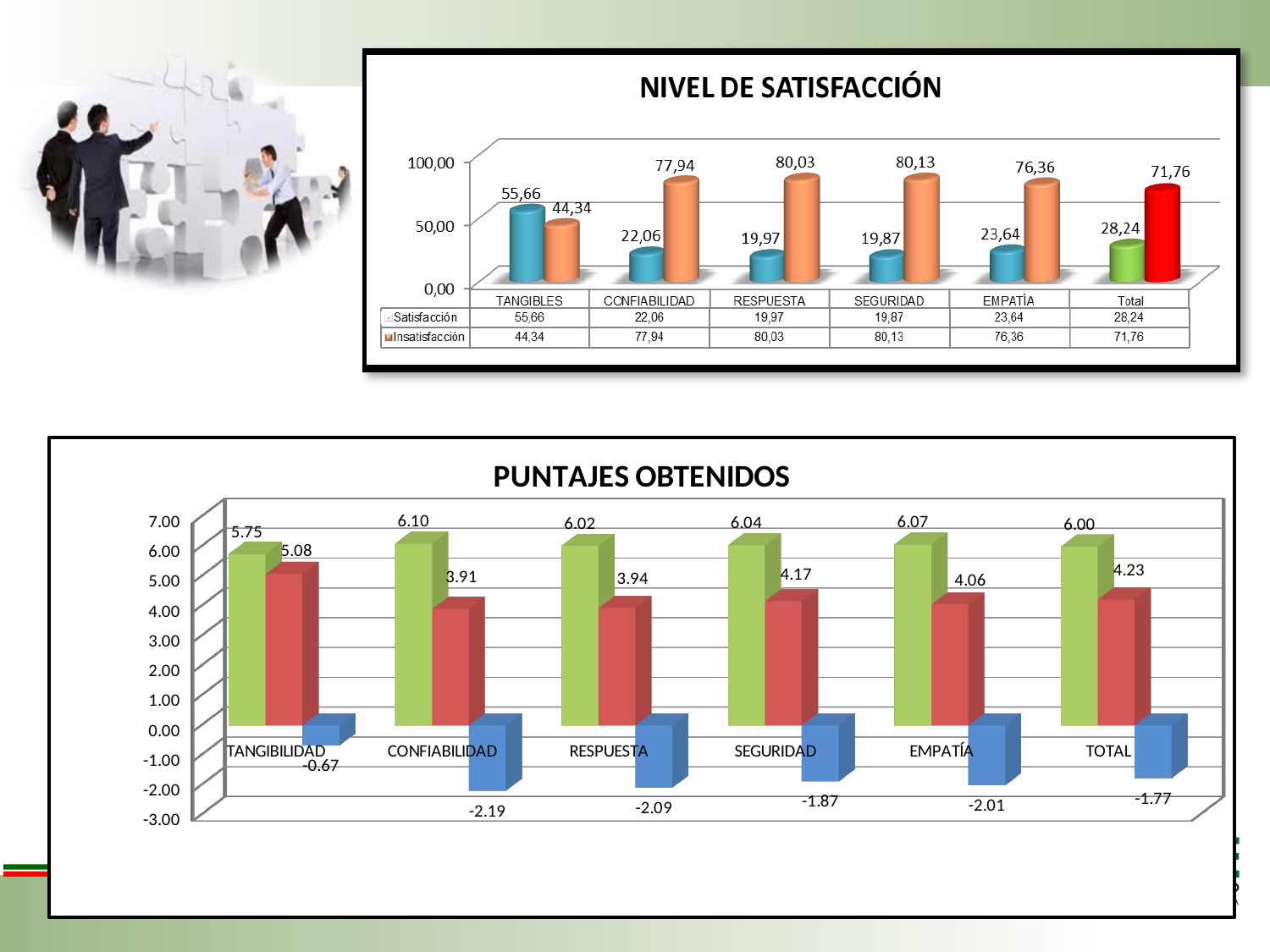
How many categories are shown on the x axis of the PUNTAJES OBTENIDOS chart? 6 In the NIVEL DE SATISFACCIÓN chart, what is the Insatisfacción value for SEGURIDAD? 80,13 In the NIVEL DE SATISFACCIÓN chart, what is the Satisfacción value for TANGIBLES? 55,66 In the NIVEL DE SATISFACCIÓN chart, which category has the highest Insatisfacción value? SEGURIDAD In the PUNTAJES OBTENIDOS chart, what is the value of the blue bar for CONFIABILIDAD? -2.19 In the NIVEL DE SATISFACCIÓN chart, is the Satisfacción value for TANGIBLES greater or less than the Insatisfacción value for TANGIBLES? greater In the NIVEL DE SATISFACCIÓN chart, what is the difference between the Insatisfacción and Satisfacción values for CONFIABILIDAD? 55,88 In the PUNTAJES OBTENIDOS chart, which category has the highest green bar value? CONFIABILIDAD In the NIVEL DE SATISFACCIÓN chart, which category has the lowest Satisfacción value? SEGURIDAD How many series does the legend of the NIVEL DE SATISFACCIÓN chart list? 2 In the PUNTAJES OBTENIDOS chart, what is the value of the red bar for TOTAL? 4.23 What kind of chart is PUNTAJES OBTENIDOS? Bar chart